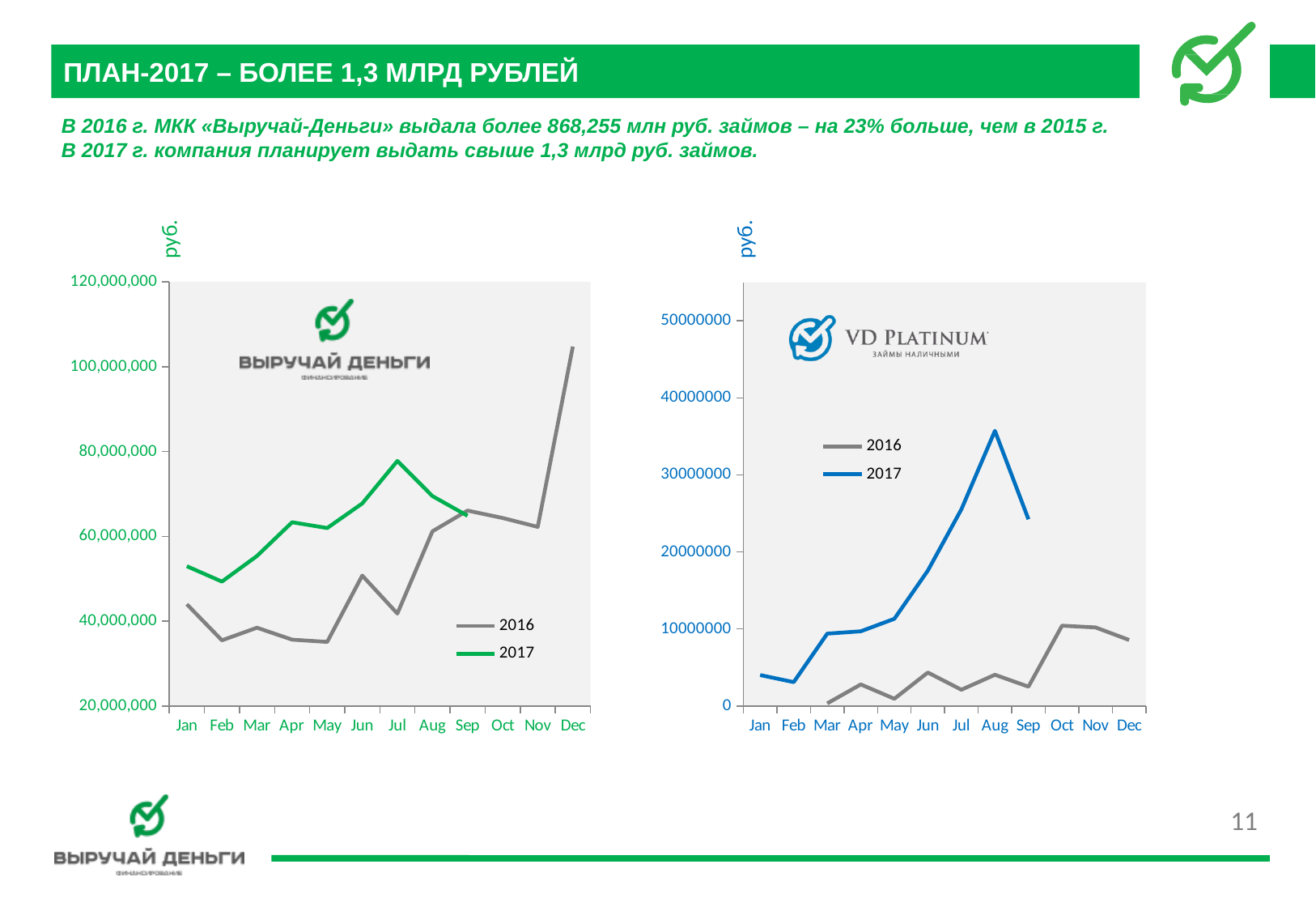
In the right chart (VD Platinum), is the 2017 value for Aug greater or less than 30000000? greater What kind of chart is the left chart (Выручай Деньги)? line chart In the right chart (VD Platinum), which month has the highest value for the 2017 series? Aug In the left chart (Выручай Деньги), which month has the highest value for the 2016 series? Dec In the right chart (VD Platinum), what colour is the line for the 2017 series? blue How many series does the legend of the right chart (VD Platinum) list? 2 In the left chart (Выручай Деньги), is the 2016 value for Dec greater or less than 100,000,000? greater In the right chart (VD Platinum), is the 2016 value for Oct greater or less than 20000000? less In the left chart (Выручай Деньги), which series has the larger value in Apr, 2016 or 2017? 2017 How many months are shown on the x axis of the left chart (Выручай Деньги)? 12 In the right chart (VD Platinum), does the 2017 series rise or fall from Mar to Aug? rise